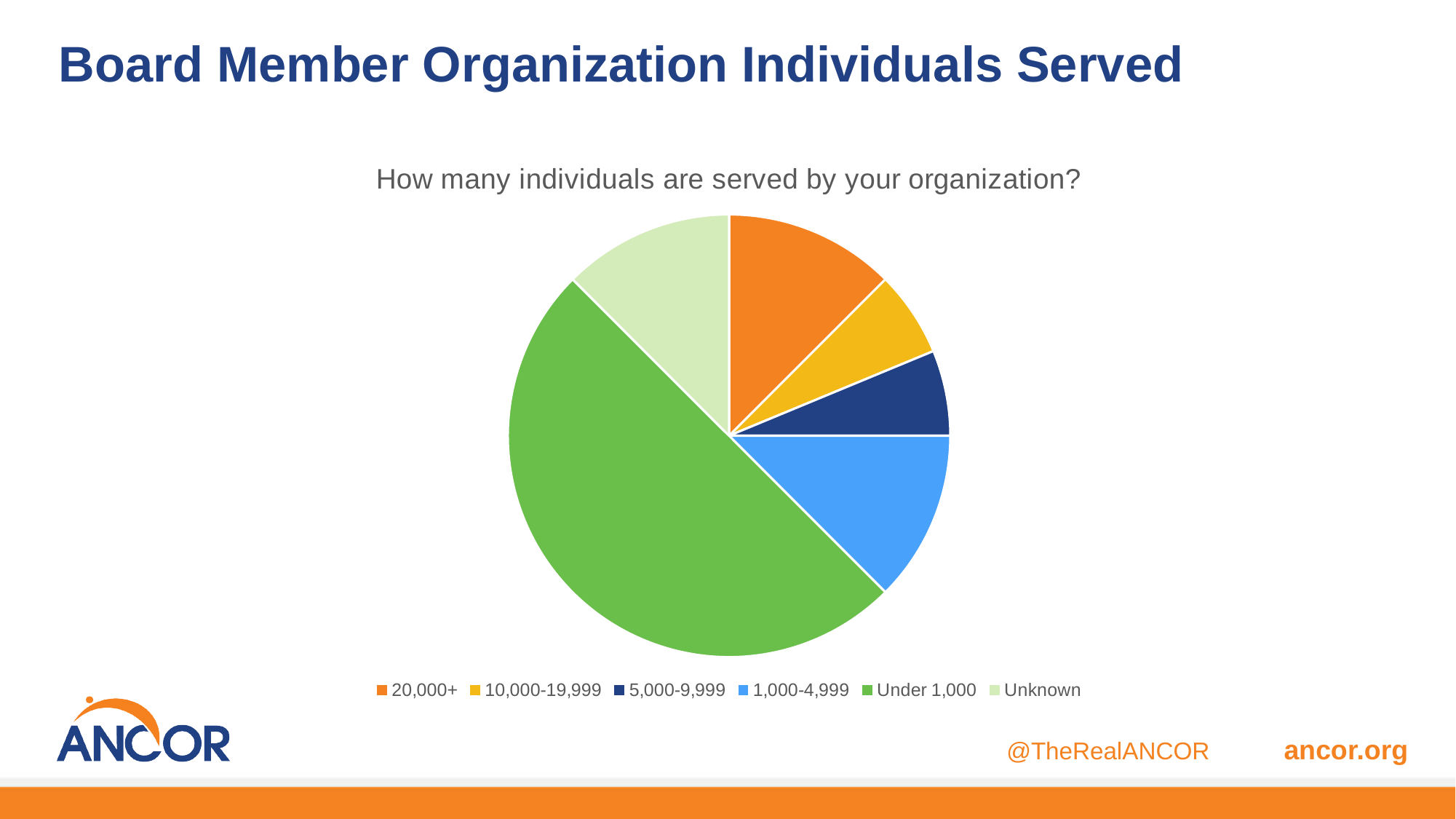
Which slice is larger: Under 1,000 or 20,000+? Under 1,000 Which category is shown in orange in the legend? 20,000+ What kind of chart is shown on the slide? pie chart Which slice is larger: Unknown or 5,000-9,999? Unknown Which category has the largest slice of the pie chart? Under 1,000 Which slice is larger: Under 1,000 or Unknown? Under 1,000 What is the title of the chart? How many individuals are served by your organization? How many categories does the pie chart show? 6